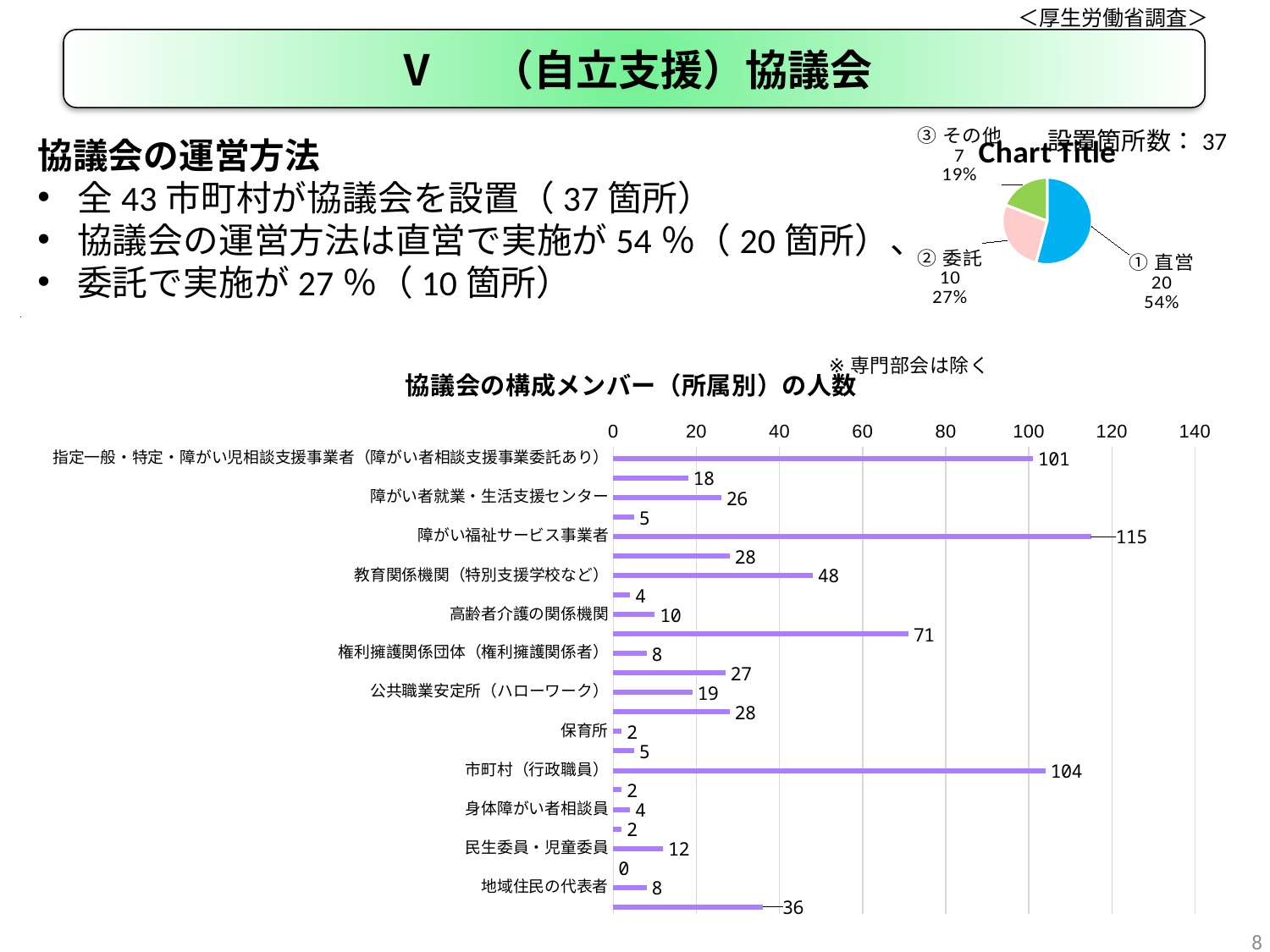
In the bar chart 協議会の構成メンバー（所属別）の人数, what is the value for 市町村（行政職員）? 104 What kind of chart is 協議会の構成メンバー（所属別）の人数? bar chart In the bar chart 協議会の構成メンバー（所属別）の人数, is the value for 指定一般・特定・障がい児相談支援事業者（障がい者相談支援事業委託あり） greater or less than 100? greater In the pie chart at the top right, what percentage share does ① 直営 have? 54% In the pie chart at the top right, how many slices are there? 3 In the pie chart at the top right, what is the value for ② 委託? 10 In the pie chart at the top right, which category has the smallest slice? ③ その他 In the bar chart 協議会の構成メンバー（所属別）の人数, which labeled category has the highest value? 障がい福祉サービス事業者 In the bar chart 協議会の構成メンバー（所属別）の人数, what is the difference between 障がい福祉サービス事業者 and 市町村（行政職員）? 11 In the bar chart 協議会の構成メンバー（所属別）の人数, what is the value for 公共職業安定所（ハローワーク）? 19 In the bar chart 協議会の構成メンバー（所属別）の人数, which is larger: 教育関係機関（特別支援学校など） or 障がい者就業・生活支援センター? 教育関係機関（特別支援学校など） In the bar chart 協議会の構成メンバー（所属別）の人数, what is the value for 障がい福祉サービス事業者? 115